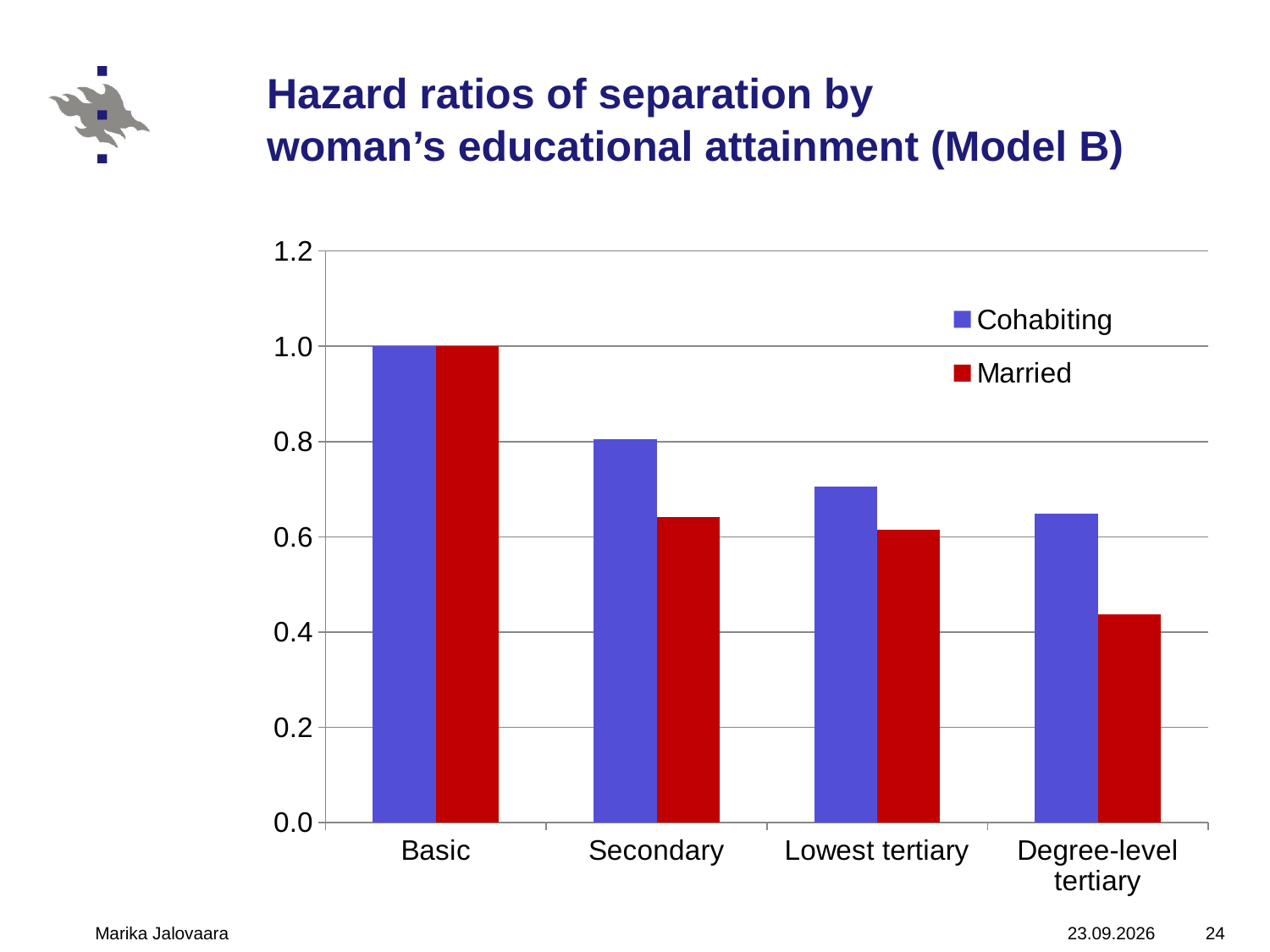
Which category has the lowest hazard ratio for the Married series? Degree-level tertiary What is the hazard ratio for Cohabiting in the Basic category? 1.0 How many educational attainment categories are shown on the x axis? 4 What is the hazard ratio for Married in the Basic category? 1.0 In the Secondary category, which series has the larger hazard ratio, Cohabiting or Married? Cohabiting Do the Married hazard ratios rise or fall as educational attainment increases from Basic to Degree-level tertiary? fall Which category has the lowest hazard ratio for the Cohabiting series? Degree-level tertiary How many series does the legend list? 2 Which category has the highest hazard ratio for the Married series? Basic Is the Married value for Degree-level tertiary greater or less than 0.6? less Is the Cohabiting value for Lowest tertiary greater or less than 0.6? greater What kind of chart is shown on the slide? bar chart